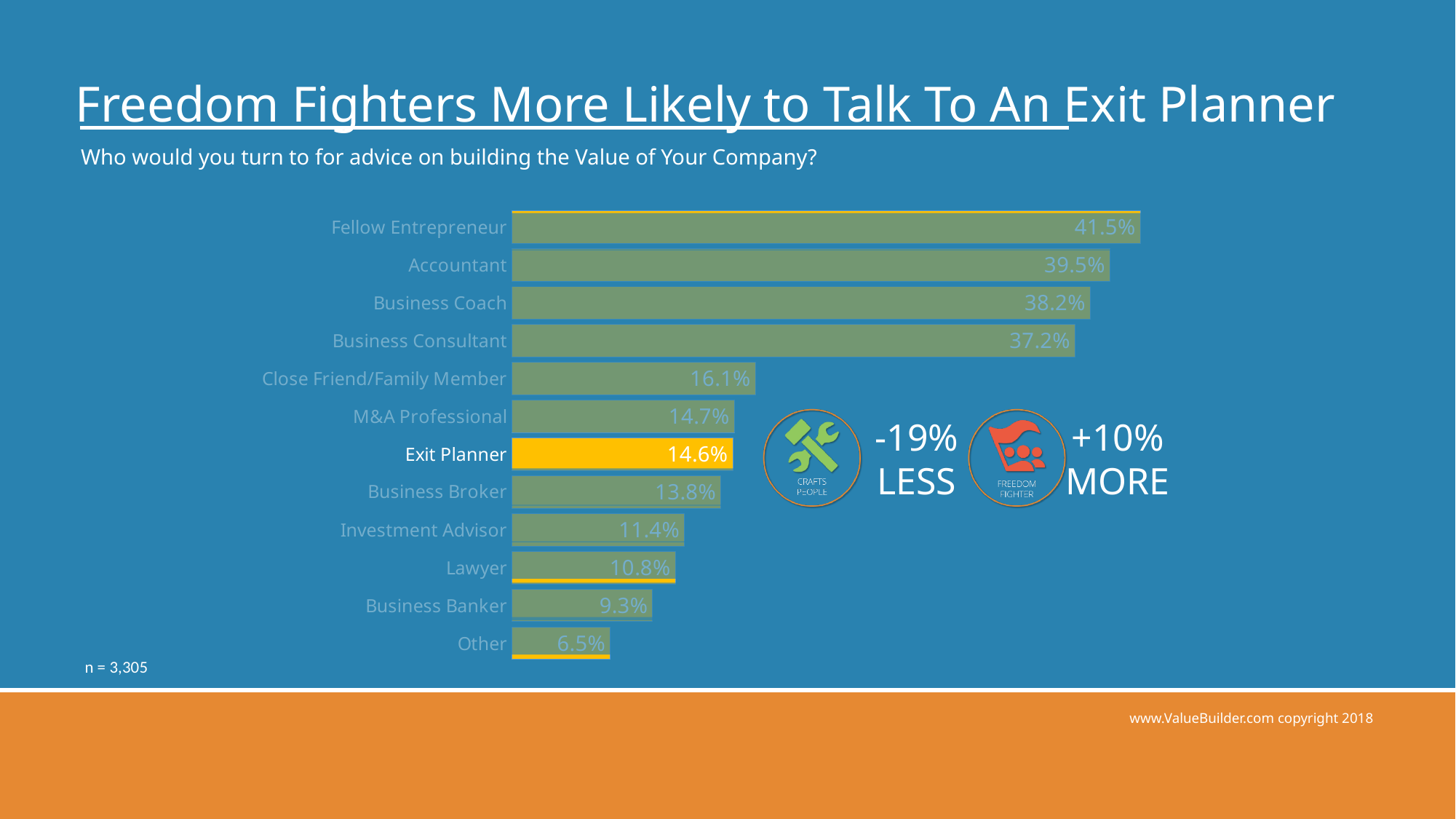
What is the difference between the values for Close Friend/Family Member and Lawyer? 5.3% Which has a larger value, Business Consultant or Investment Advisor? Business Consultant Which category has the lowest value in the chart? Other What type of chart is shown on the slide? Bar chart Which has a larger value, Business Broker or Other? Business Broker What is the difference between the values for Accountant and Business Coach? 1.3% Which bar in the chart is highlighted in yellow? Exit Planner What is the value shown for Business Banker? 9.3% Which category has the highest value in the chart? Fellow Entrepreneur How many categories are shown in the bar chart? 12 What percentage of respondents would turn to a Fellow Entrepreneur for advice on building the value of their company? 41.5% What is the value shown for Exit Planner? 14.6%